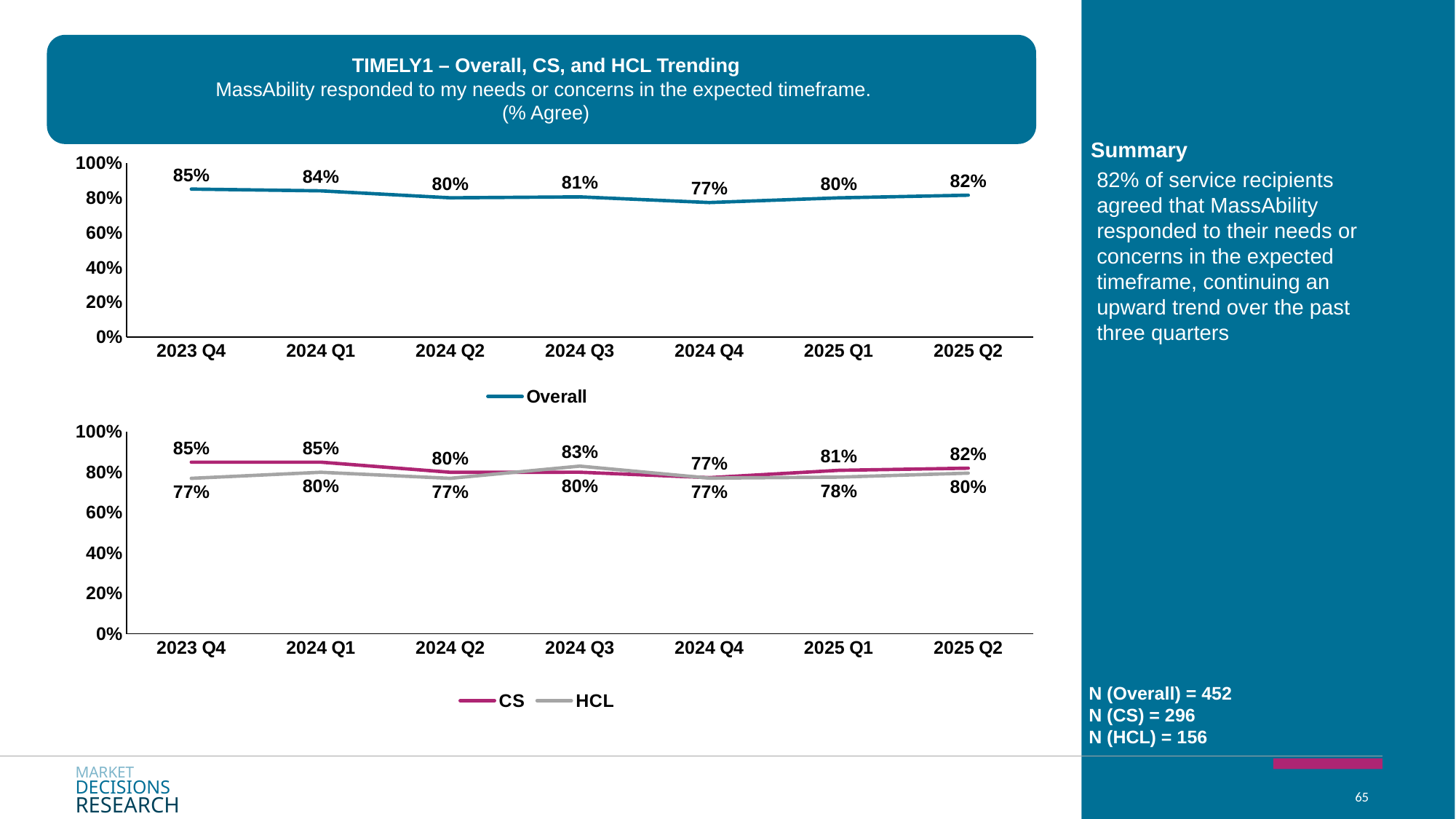
In the bottom chart (CS and HCL), which series has the larger value in 2023 Q4, CS or HCL? CS In the top chart (Overall), what is the value for 2024 Q4? 77% In the top chart (Overall), which quarter has the highest value? 2023 Q4 In the top chart (Overall), how many quarters are plotted? 7 In the bottom chart (CS and HCL), what is the CS value for 2025 Q1? 81% In the bottom chart (CS and HCL), what is the difference between the CS and HCL values in 2023 Q4? 8% In the bottom chart (CS and HCL), what is the HCL value for 2024 Q3? 83% In the top chart (Overall), which quarter has the lowest value? 2024 Q4 What kind of chart is the top chart (Overall)? Line chart In the top chart (Overall), what is the difference between the 2023 Q4 value and the 2025 Q2 value? 3% In the top chart (Overall), do the values rise or fall from 2024 Q4 to 2025 Q2? Rise In the bottom chart (CS and HCL), how many series does the legend list? 2